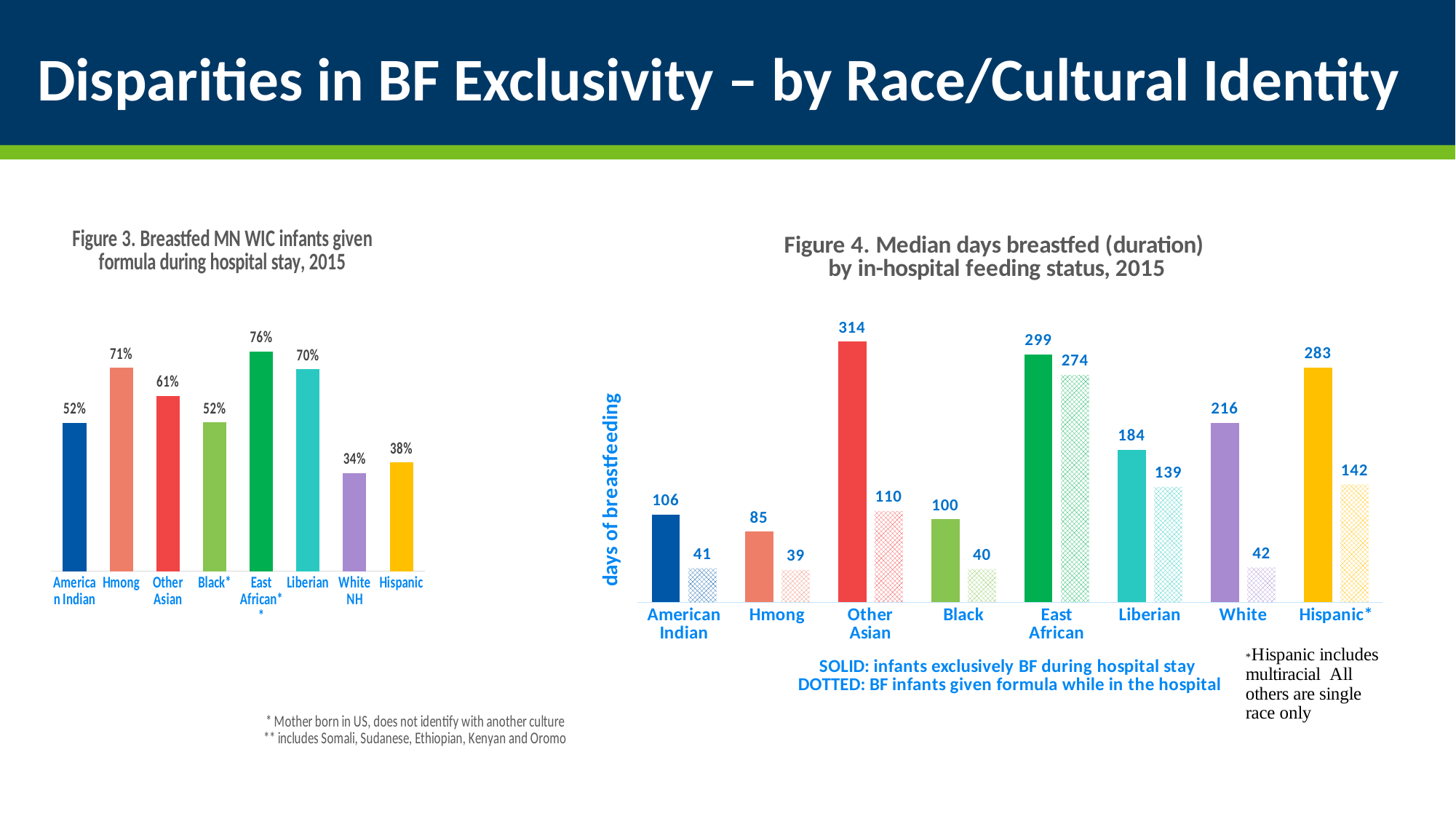
In Figure 4, what is the median days breastfed for Liberian infants given formula while in the hospital? 139 In Figure 4, what is the difference between the solid and dotted bars for White? 174 In Figure 3, which group has the highest percentage of breastfed infants given formula during the hospital stay? East African In Figure 3, what percentage of breastfed Hmong infants were given formula during the hospital stay? 71% What type of chart is Figure 4? Bar chart In Figure 4, what is the median days breastfed for Other Asian infants exclusively breastfed during the hospital stay? 314 In Figure 3, how many race/cultural identity groups are shown? 8 In Figure 4, what does a dotted bar represent? BF infants given formula while in the hospital In Figure 3, which group has the lowest percentage? White NH In Figure 4, which is larger: the solid bar for East African or the solid bar for Hispanic? East African In Figure 4, which group has the lowest median days breastfed among infants given formula in the hospital (dotted bars)? Hmong In Figure 3, what is the difference in percentage points between Liberian and Hispanic? 32